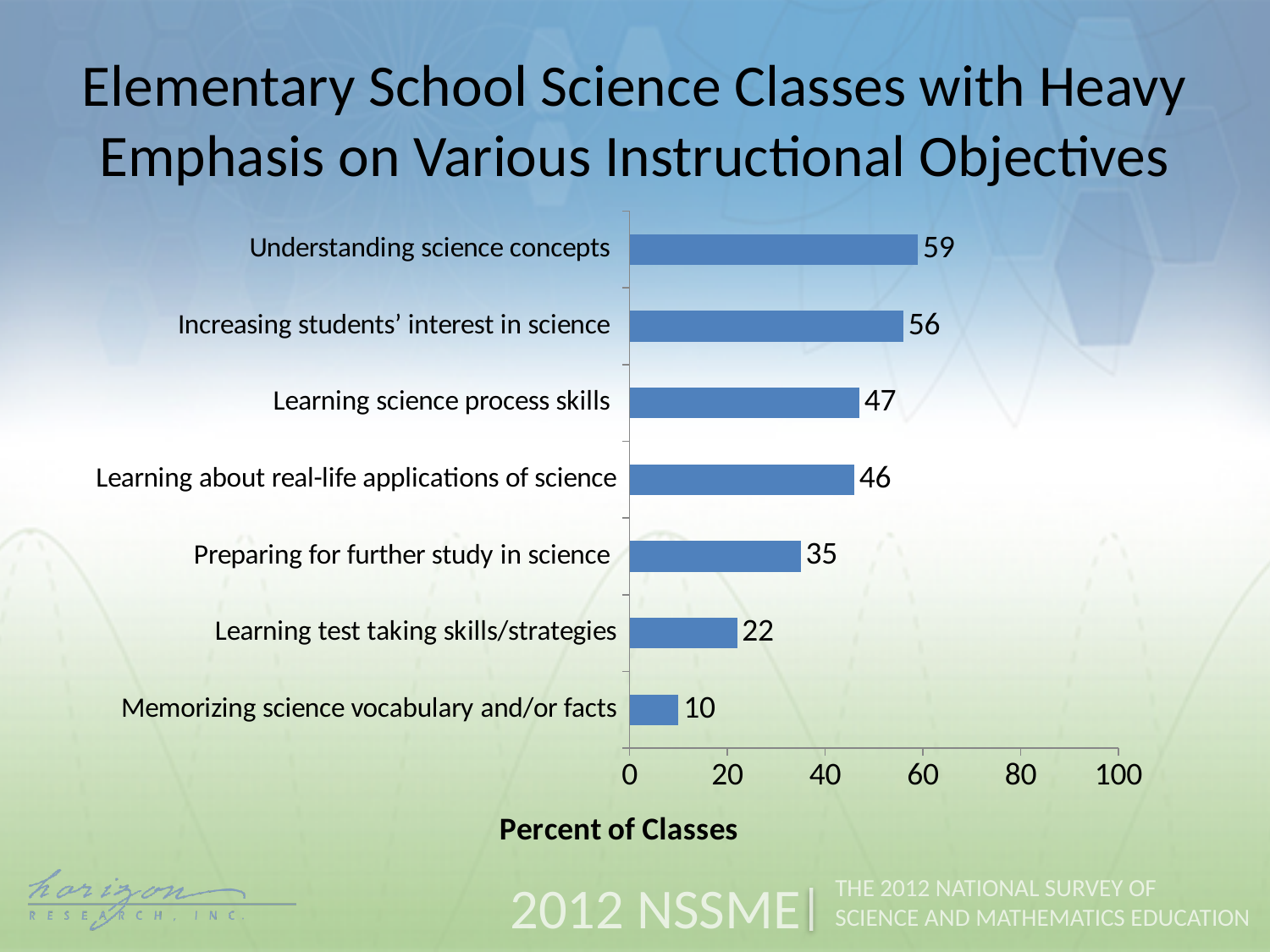
Which instructional objective has the lowest percent of classes? Memorizing science vocabulary and/or facts What is the value for preparing for further study in science? 35 What is the label of the horizontal axis? Percent of Classes What percent of classes place heavy emphasis on understanding science concepts? 59 Which is larger: the value for increasing students' interest in science or the value for preparing for further study in science? Increasing students' interest in science How many instructional objectives are shown in the chart? 7 Which instructional objective has the highest percent of classes? Understanding science concepts What kind of chart is shown on the slide? Bar chart Is the value for learning test taking skills/strategies greater or less than 40? less What is the difference between the values for learning science process skills and learning about real-life applications of science? 1 What is the difference between the values for understanding science concepts and memorizing science vocabulary and/or facts? 49 What is the value for learning test taking skills/strategies? 22